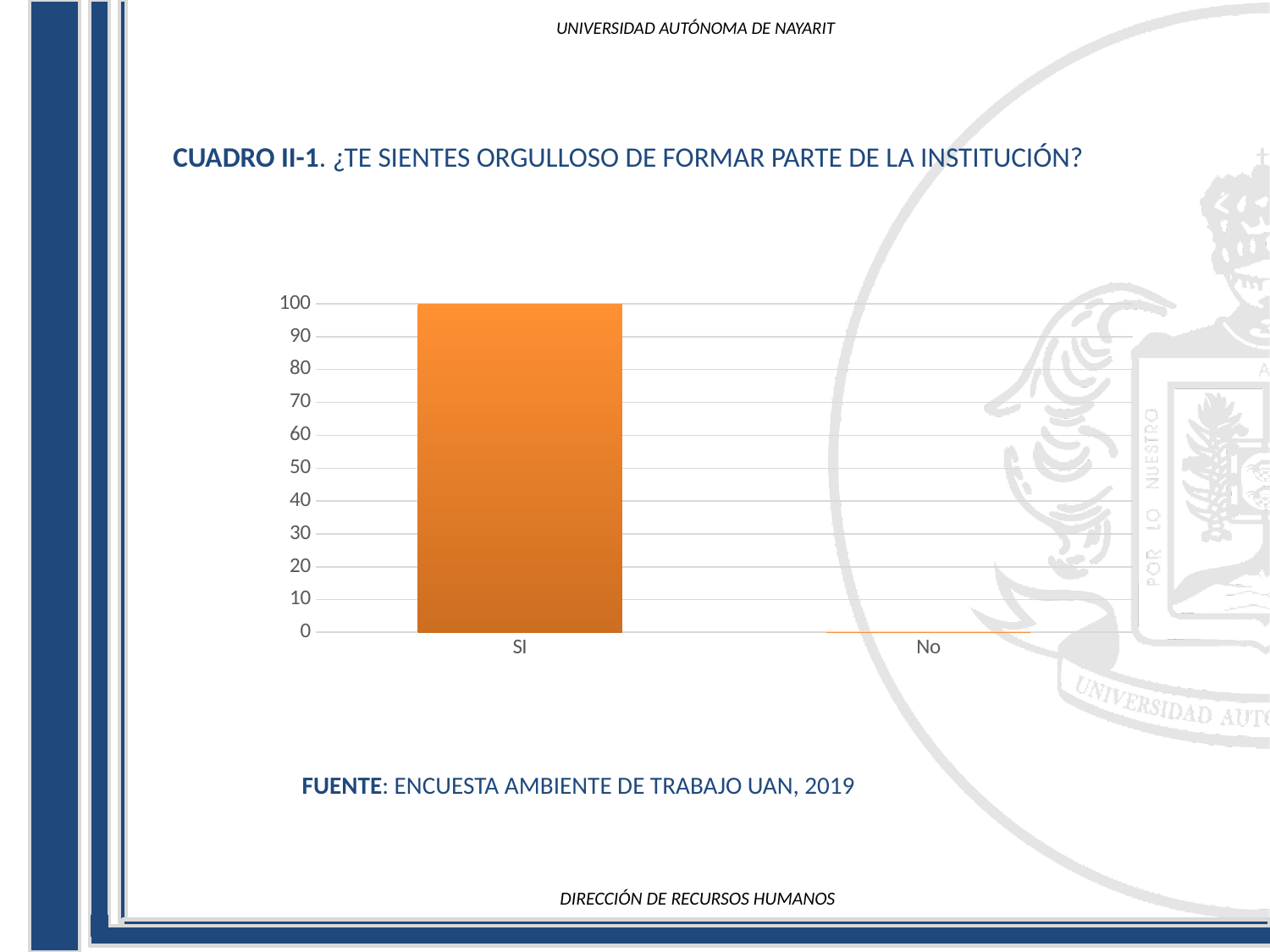
What is the difference between the values for SI and No? 100 How many categories are shown on the x axis? 2 What kind of chart is shown on the slide? bar chart Which is larger, the value for SI or the value for No? SI What source is cited below the chart? ENCUESTA AMBIENTE DE TRABAJO UAN, 2019 Which category has the lowest value? No What is the highest value shown on the vertical axis? 100 Is the value for SI greater or less than 50? greater What is the value for No? 0 What is the value for SI? 100 Which category has the highest value? SI